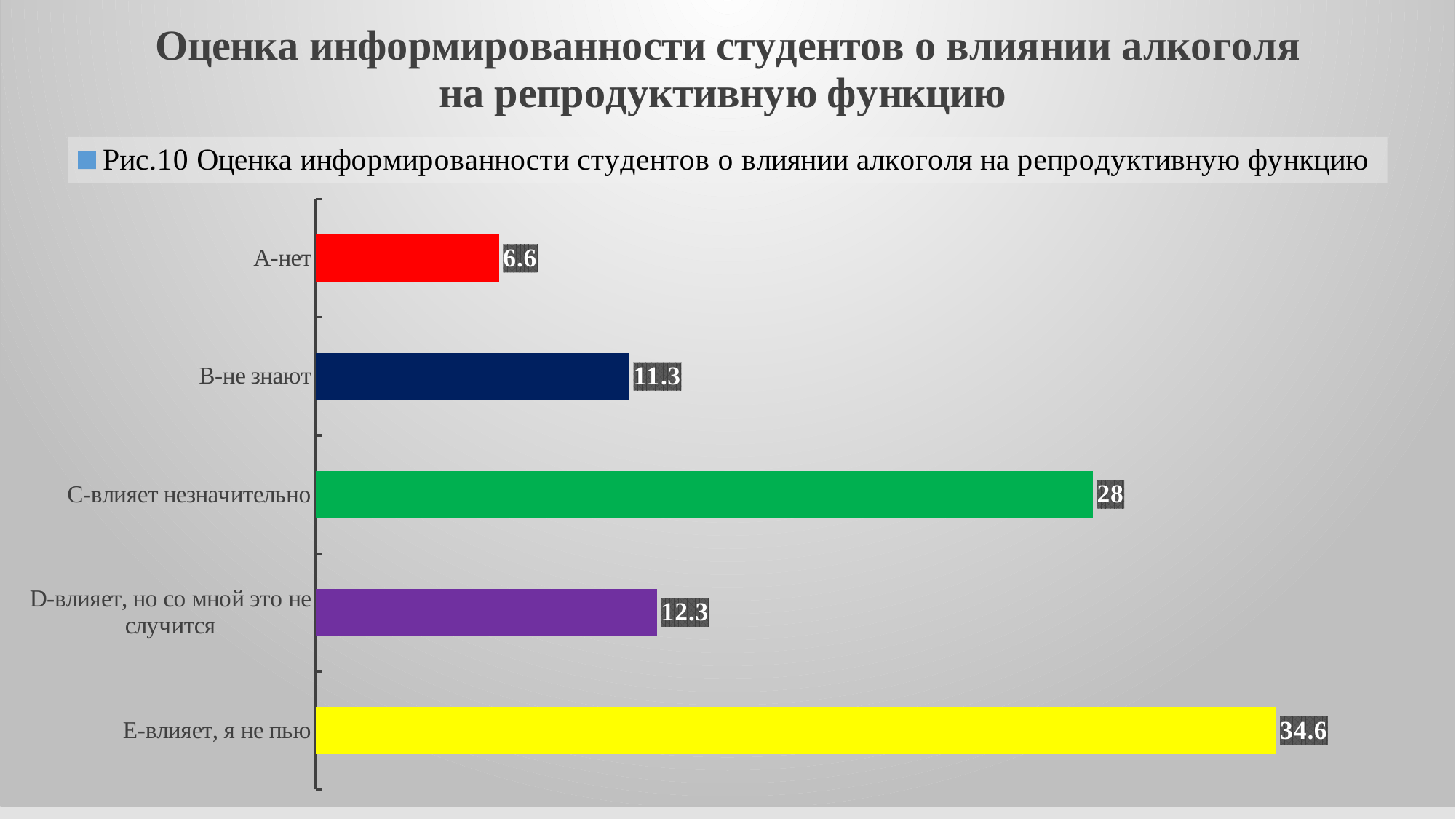
What colour is the bar for 'C-влияет незначительно'? Green What kind of chart is shown on the slide? Bar chart What is the value for the category 'C-влияет незначительно'? 28 What is the difference between the values for 'E-влияет, я не пью' and 'C-влияет незначительно'? 6.6 Which is larger, the value for 'B-не знают' or the value for 'D-влияет, но со мной это не случится'? D-влияет, но со мной это не случится Which category has the highest value? E-влияет, я не пью What is the value for the category 'D-влияет, но со мной это не случится'? 12.3 Which category has the lowest value? A-нет What is the value for the category 'B-не знают'? 11.3 What is the value for the category 'A-нет'? 6.6 How many categories are shown in the chart? 5 What is the value for the category 'E-влияет, я не пью'? 34.6